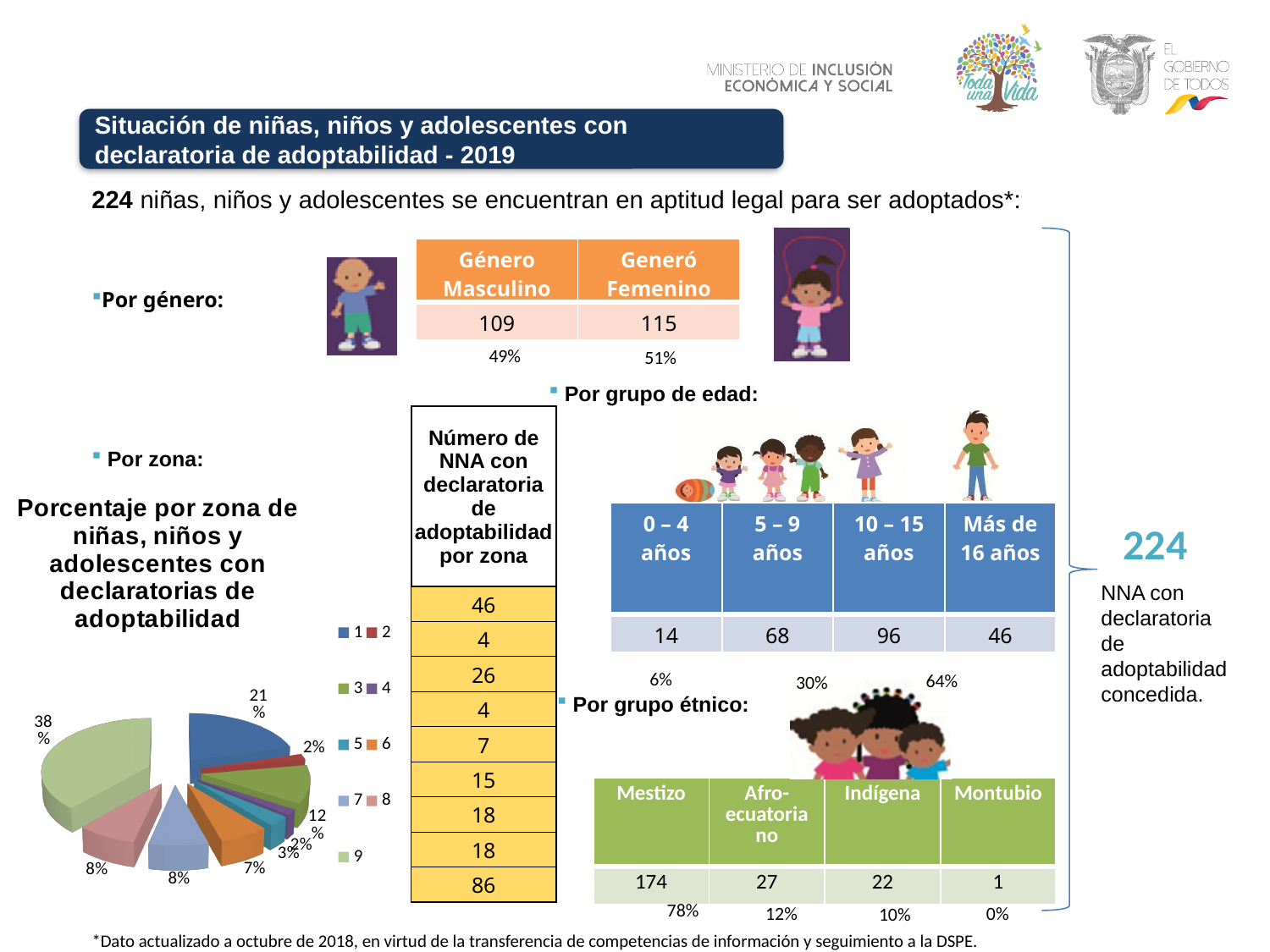
What percentage does the pie chart show for zone 1? 21% What percentage does the pie chart show for zone 3? 12% Which slice is larger on the pie chart, zone 1 or zone 3? zone 1 What is the title of the pie chart? Porcentaje por zona de niñas, niños y adolescentes con declaratorias de adoptabilidad What kind of chart is shown on the slide? pie chart What is the smallest percentage shown on the pie chart? 2% What is the largest percentage shown on the pie chart? 38% How many entries does the legend of the pie chart list? 9 What is the difference in percentage points between the largest slice (38%) and the 21% slice of the pie chart? 17 What percentage does the pie chart show for zone 9? 38% What are the legend entries of the pie chart? 1, 2, 3, 4, 5, 6, 7, 8, 9 How many slices does the pie chart have? 9